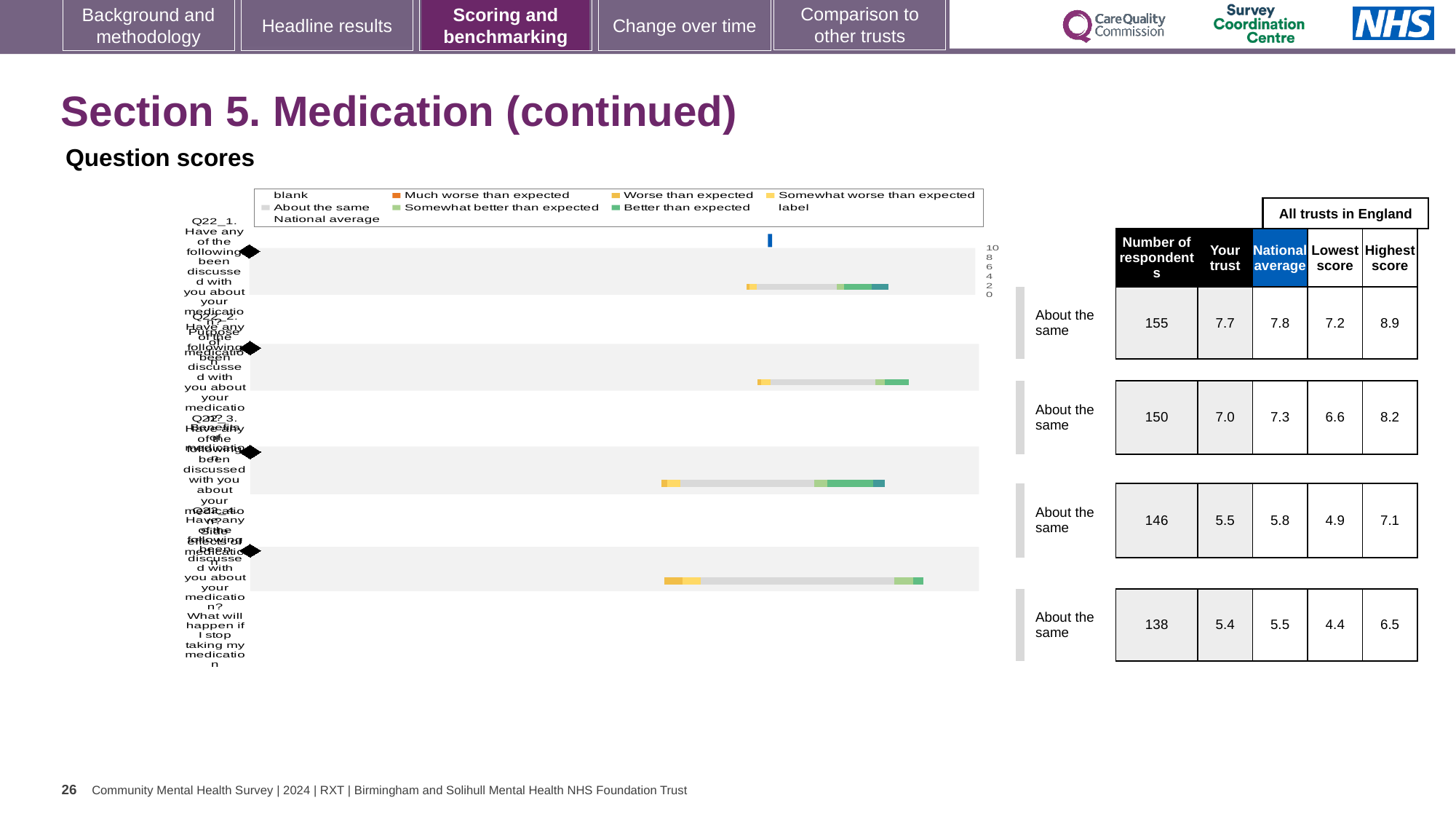
How many horizontal bars are plotted in the question scores chart? 4 Which row in the table beside the chart has the highest 'Your trust' score? the first row (Q22_1), 7.7 What is the highest value shown on the chart's axis scale? 10 In the table beside the chart, is the 'Your trust' score or the national average larger for the first row (Q22_1)? National average In the table beside the chart, what is the difference between the national average and the 'Your trust' score for the third row (Q22_3)? 0.3 Which row in the table beside the chart has the lowest 'Your trust' score? the fourth row (Q22_4), 5.4 What benchmark category label is shown next to each of the four bars in the chart? About the same In the table beside the chart, what is the 'Your trust' score for the first row (Q22_1)? 7.7 In the table beside the chart, how many respondents are listed for the fourth row (Q22_4)? 138 In the table beside the chart, what is the highest score among all trusts in England for the second row (Q22_2)? 8.2 In the table beside the chart, what is the national average for the second row (Q22_2)? 7.3 What kind of chart is shown under 'Question scores'? bar chart